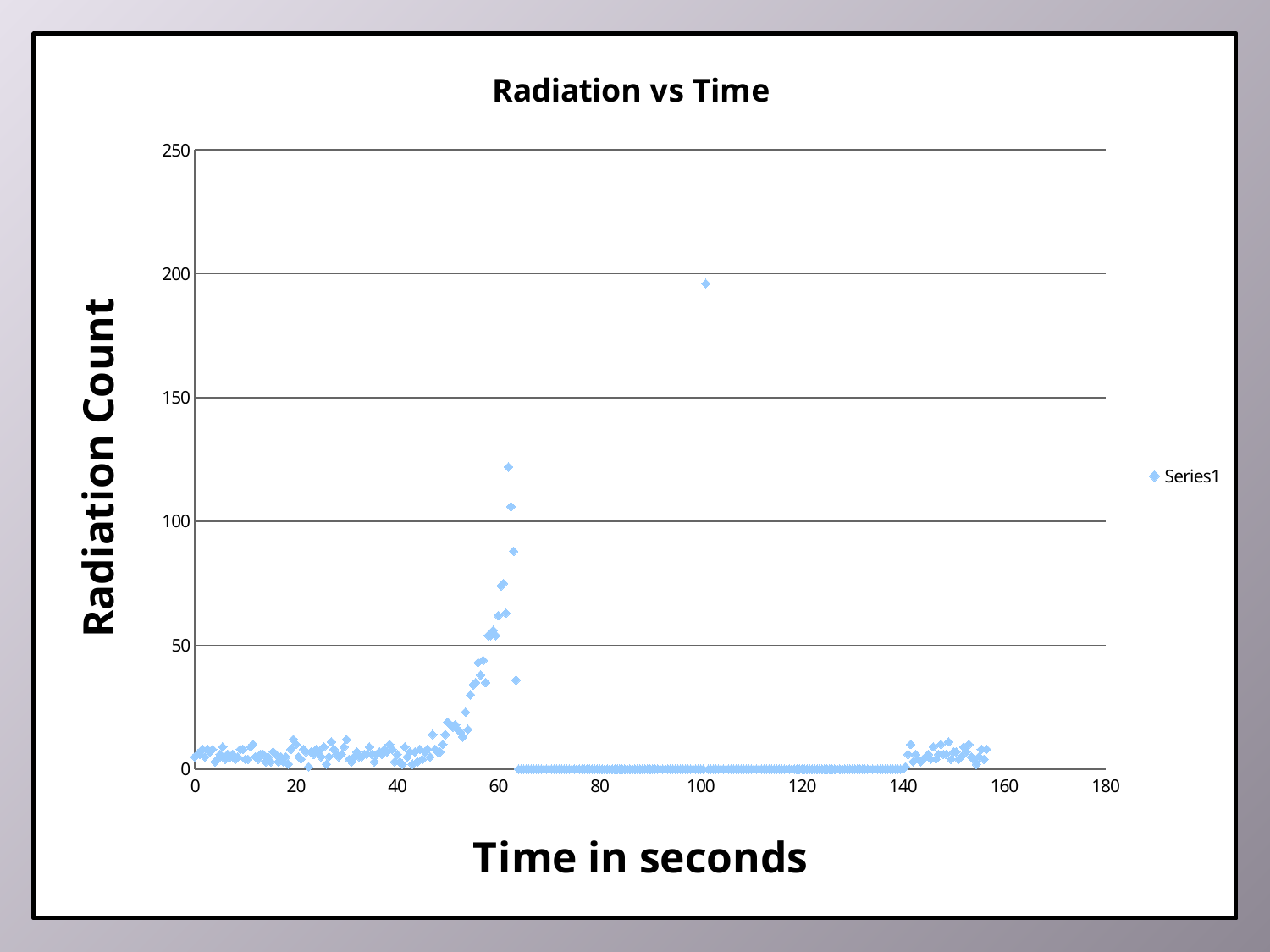
Is the highest point on the chart at a time greater or less than 80 seconds? greater What kind of chart is shown on the slide? scatter chart How many series does the legend list? 1 Is the highest radiation count recorded near 60 seconds greater or less than 100? greater What is the title of the chart? Radiation vs Time Do the radiation counts rise or fall as time increases from 40 to 60 seconds? rise Is the highest radiation count plotted on the chart greater or less than 200? less What is the label on the vertical axis of the chart? Radiation Count What is the highest value shown on the vertical axis of the chart? 250